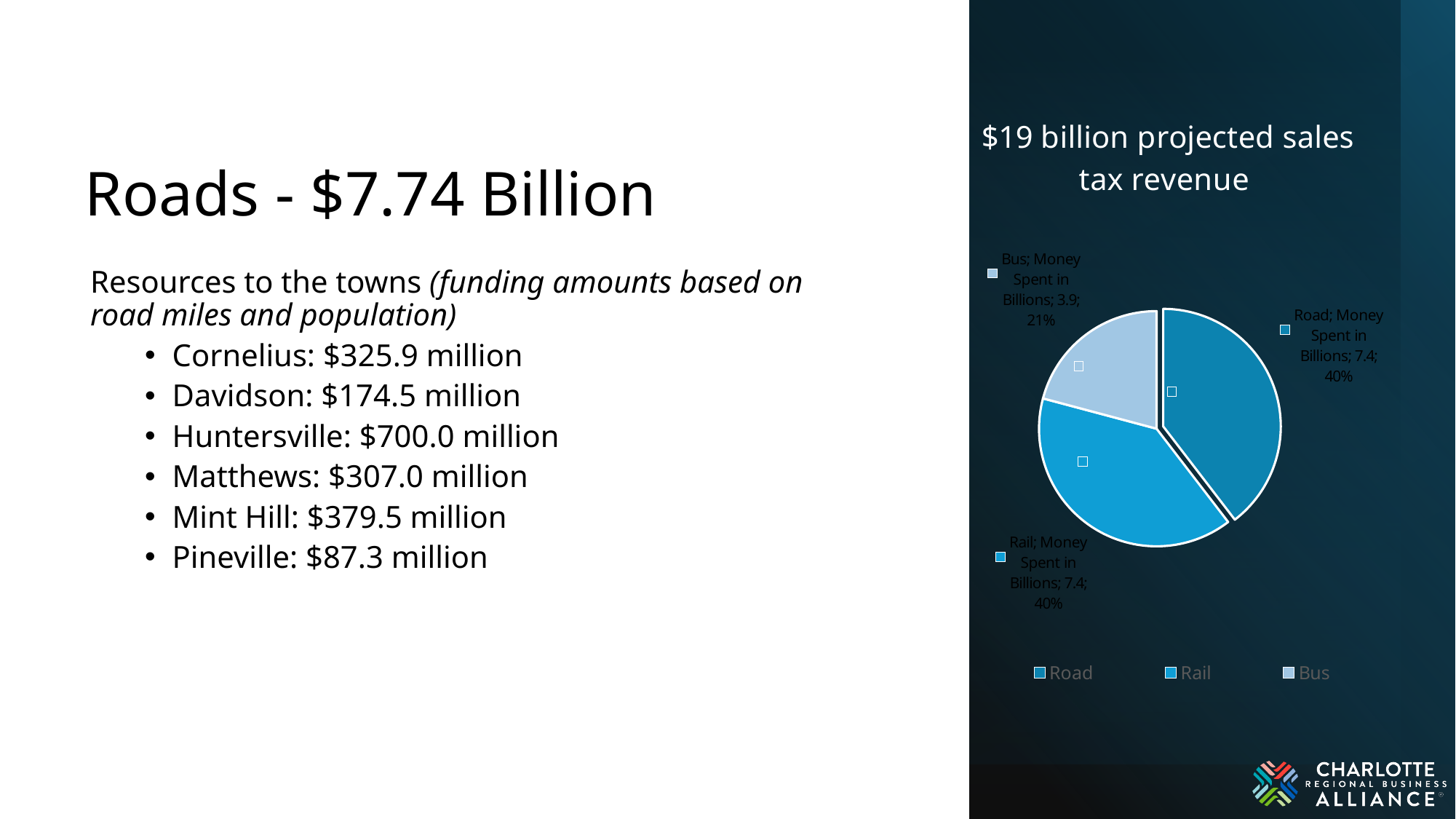
What value (money spent in billions) is shown for Road? 7.4 What share of the pie does Road represent? 40% What is the title of the chart? $19 billion projected sales tax revenue What kind of chart is shown on the slide? pie chart How many slices does the pie chart have? 3 What value (money spent in billions) is shown for Rail? 7.4 What share of the pie does Bus represent? 21% How many entries does the chart legend list? 3 Which is larger, the value for Road or the value for Bus? Road Which category has the smallest slice of the pie? Bus What value (money spent in billions) is shown for Bus? 3.9 What is the difference between the values for Rail and Bus? 3.5